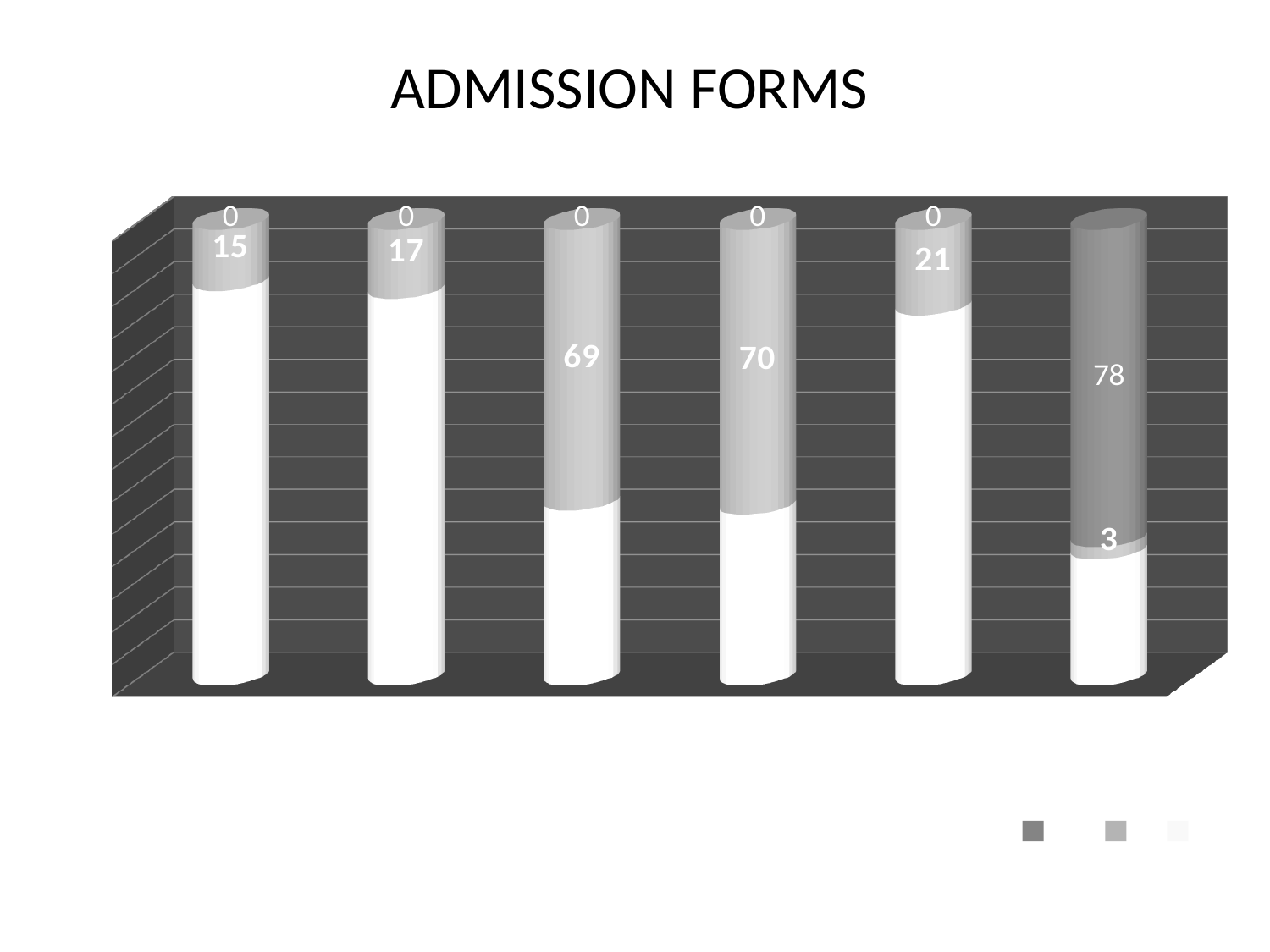
What value is labelled on the grey segment of the rightmost bar? 3 What is the difference between the grey segment values of the fifth bar (21) and the first bar (15)? 6 What value is labelled at the top of the second bar from the left? 0 What value is labelled on the grey segment of the first bar from the left? 15 What kind of chart is shown on the slide? Stacked bar chart What value is labelled on the grey segment of the third bar from the left? 69 Which is larger, the grey segment value of the third bar (69) or of the fourth bar (70)? The fourth bar, 70 How many series does the legend show? 3 How many bars are plotted in the chart? 6 Which bar carries the largest printed segment value? The sixth (rightmost) bar, 78 What is the title of the chart? ADMISSION FORMS What value is labelled on the dark segment of the sixth (rightmost) bar? 78